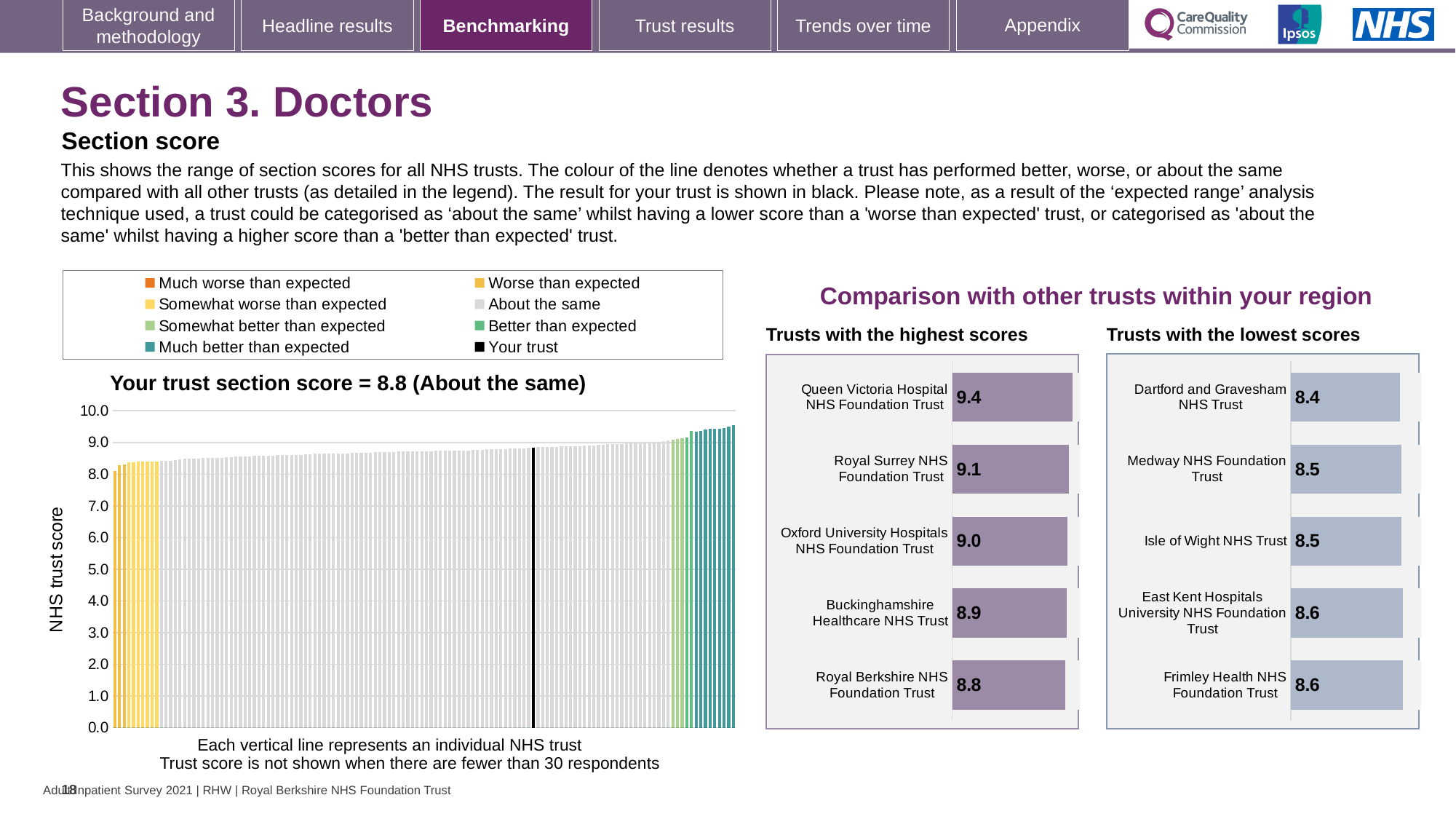
In the 'Trusts with the lowest scores' chart, which trust has the lowest score? Dartford and Gravesham NHS Trust In the 'Your trust section score' chart, what is the section score for your trust? 8.8 How many trusts are shown in the 'Trusts with the highest scores' chart? 5 What kind of chart is the 'Your trust section score' chart? bar chart In the 'Trusts with the highest scores' chart, what is the difference between the scores of Queen Victoria Hospital NHS Foundation Trust and Royal Berkshire NHS Foundation Trust? 0.6 In the 'Your trust section score' chart, what is the label on the vertical axis? NHS trust score In the 'Trusts with the highest scores' chart, what is the score for Queen Victoria Hospital NHS Foundation Trust? 9.4 In the 'Trusts with the lowest scores' chart, which has the larger score: Medway NHS Foundation Trust or East Kent Hospitals University NHS Foundation Trust? East Kent Hospitals University NHS Foundation Trust How many entries does the legend above the 'Your trust section score' chart list? 8 In the 'Trusts with the lowest scores' chart, what is the score for Isle of Wight NHS Trust? 8.5 In the 'Trusts with the highest scores' chart, which trust has the highest score? Queen Victoria Hospital NHS Foundation Trust In the 'Your trust section score' chart, are the values for the tallest teal bars at the right greater or less than 9.0? greater